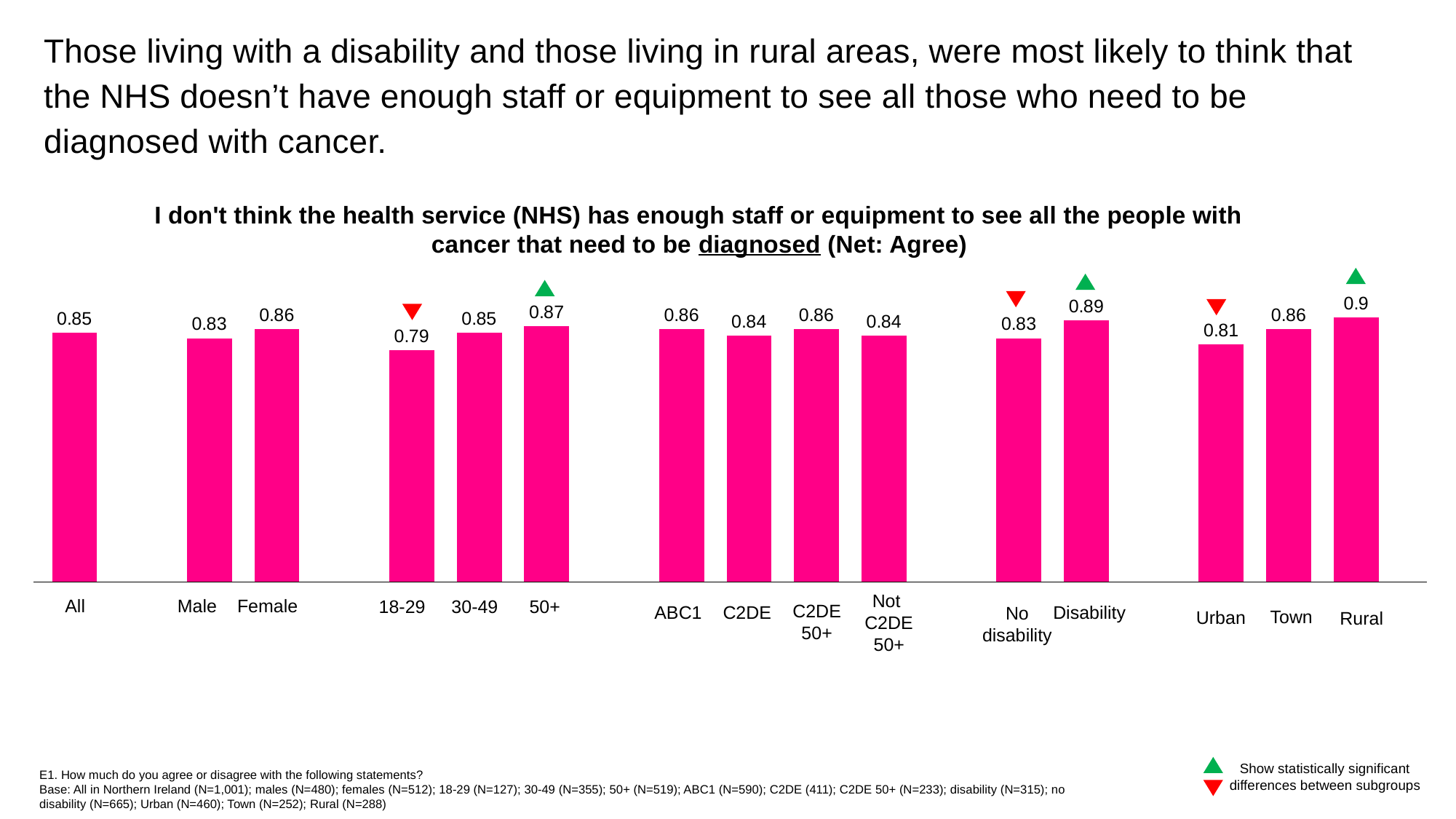
What is the difference between the values for Rural and Urban? 0.09 Do the values rise or fall across the age groups from 18-29 to 50+? Rise Which category has the highest value? Rural Which category has the lowest value? 18-29 What is the value for All? 0.85 What is the value for 18-29? 0.79 What is the value for Rural? 0.9 What is the value for Disability? 0.89 What is the difference between the values for Disability and No disability? 0.06 What kind of chart is shown on the slide? Bar chart Which is larger, the value for Female or the value for Male? Female How many categories are shown on the chart? 15